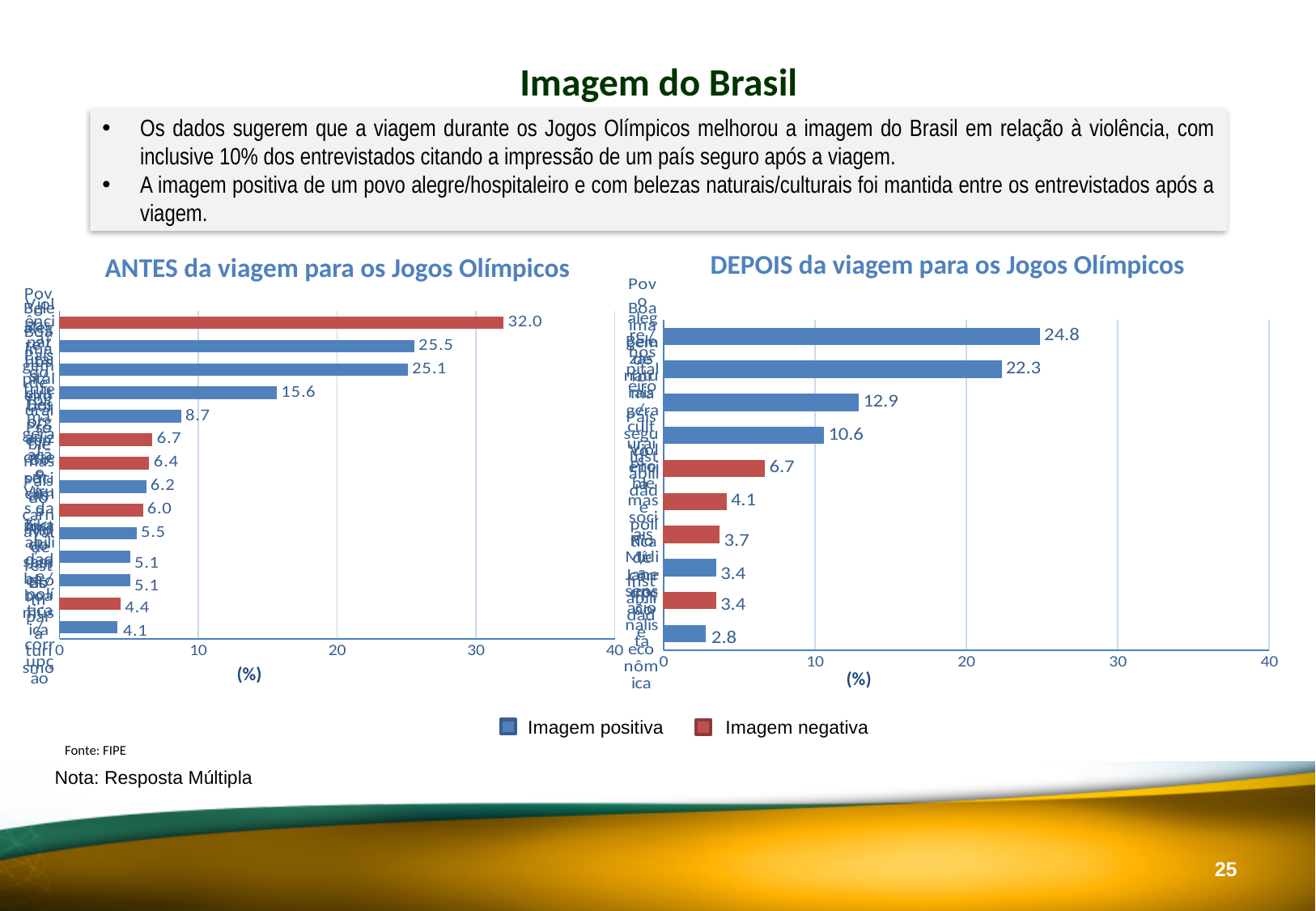
Which chart has the larger top value, 'ANTES da viagem' or 'DEPOIS da viagem'? ANTES da viagem In the 'ANTES da viagem para os Jogos Olímpicos' chart, what is the lowest value shown? 4.1 How many bars are plotted in the 'DEPOIS da viagem para os Jogos Olímpicos' chart? 10 In the 'DEPOIS da viagem para os Jogos Olímpicos' chart, what is the lowest value shown? 2.8 In the 'ANTES da viagem para os Jogos Olímpicos' chart, which legend series does the longest bar (32.0) belong to? Imagem negativa In the 'ANTES da viagem para os Jogos Olímpicos' chart, what is the highest value shown? 32.0 How many series does the shared legend below the two charts list? 2 In the 'DEPOIS da viagem para os Jogos Olímpicos' chart, what is the highest value shown? 24.8 How many bars are plotted in the 'ANTES da viagem para os Jogos Olímpicos' chart? 14 What is the difference between the highest value in the 'ANTES' chart and the highest value in the 'DEPOIS' chart? 7.2 What kind of chart is the 'ANTES da viagem para os Jogos Olímpicos' chart? bar chart What are the two entries in the legend below the charts? Imagem positiva, Imagem negativa